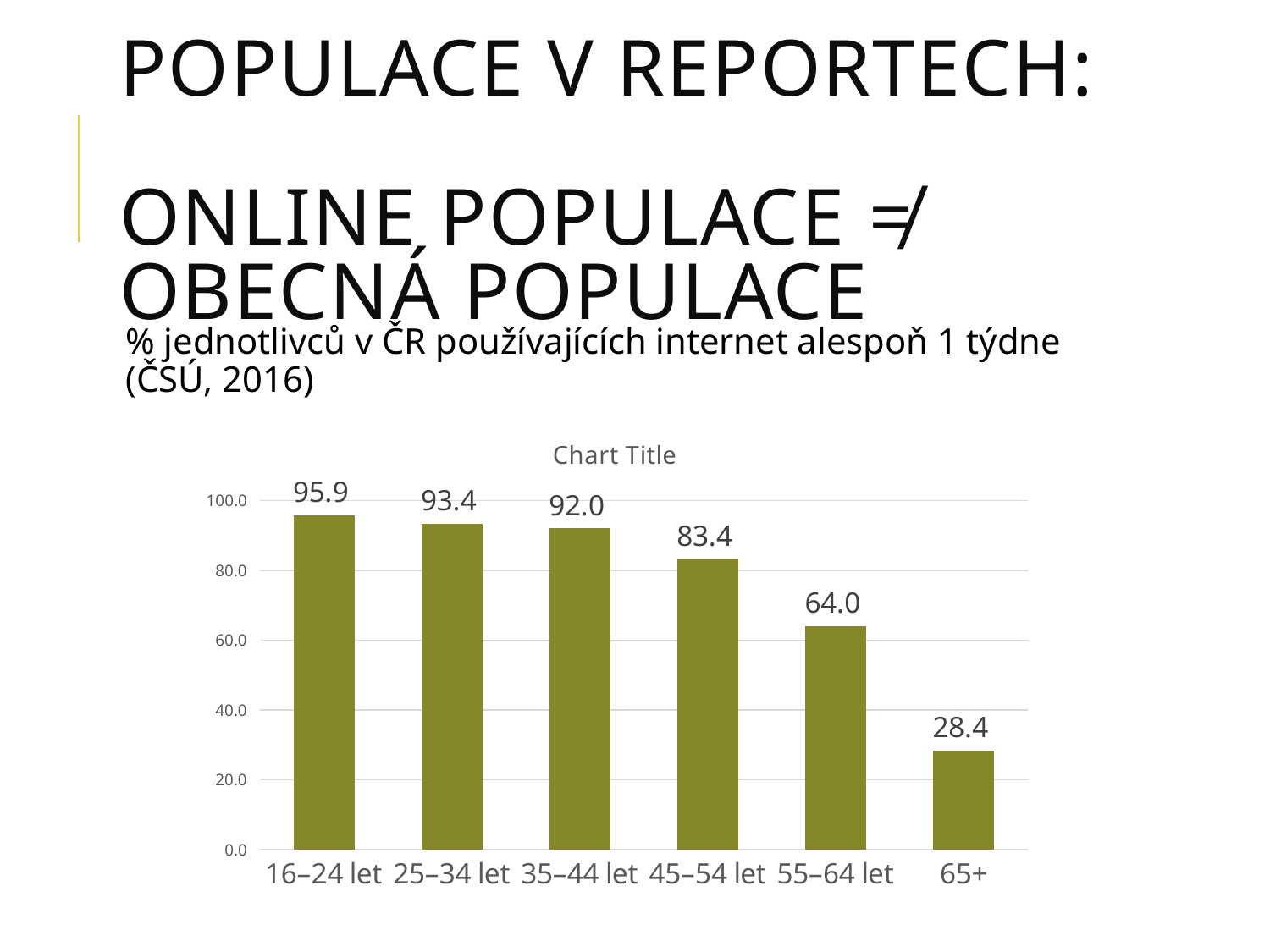
What kind of chart is shown on the slide? bar chart How many age groups are shown in the chart? 6 Which is larger, the value for 35–44 let or the value for 55–64 let? 35–44 let What is the difference between the values for 16–24 let and 45–54 let? 12.5 What is the value for the 45–54 let age group? 83.4 What is the difference between the values for 55–64 let and 65+? 35.6 Which age group has the highest value? 16–24 let Which age group has the lowest value? 65+ Do the values rise or fall from left to right across the age groups? fall What is the value for the 65+ age group? 28.4 What is the value for the 16–24 let age group? 95.9 Is the value for 55–64 let greater or less than 80.0? less